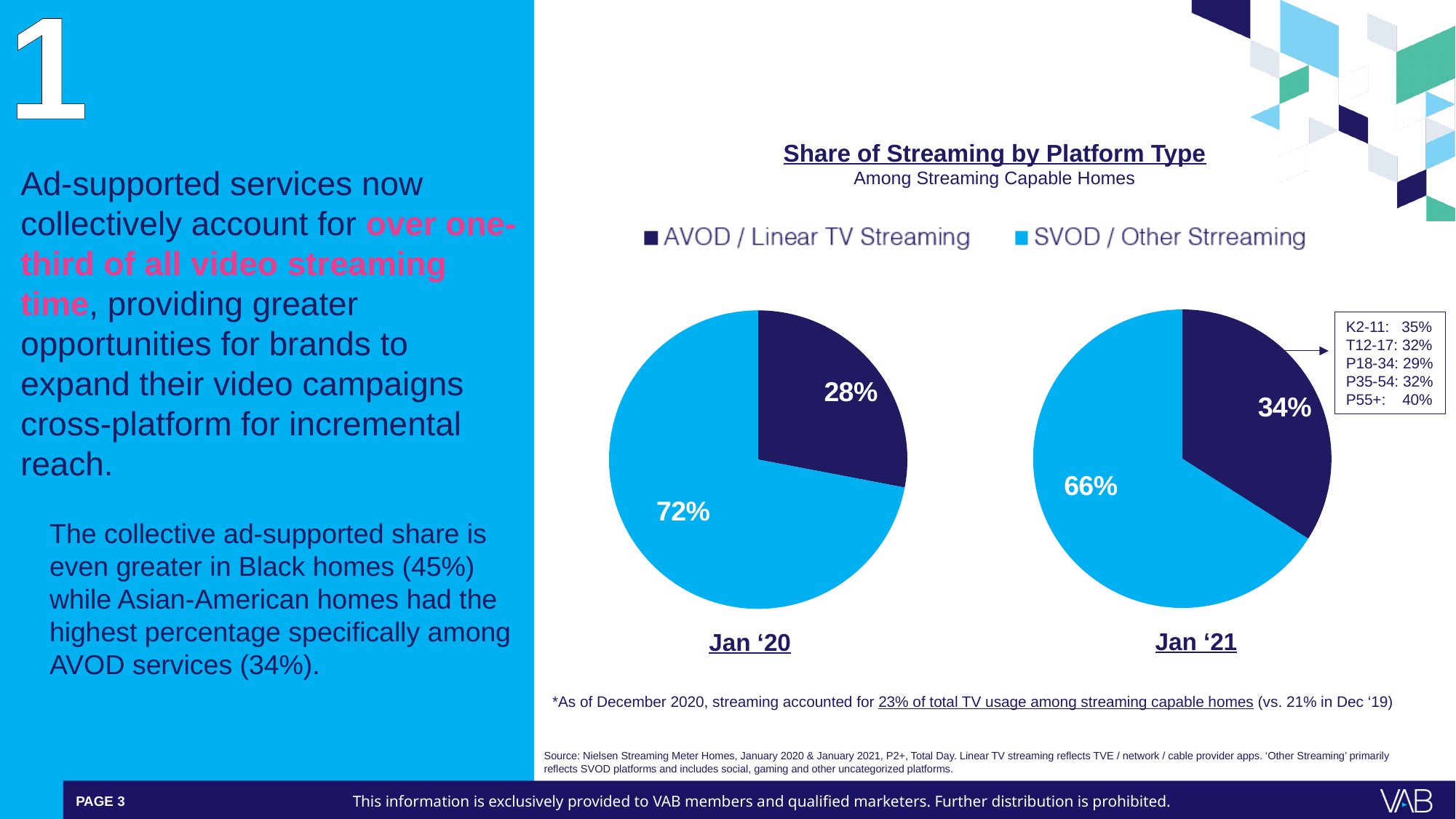
What is the title of the charts on the slide? Share of Streaming by Platform Type In the Jan '21 pie chart, which slice is the largest? SVOD / Other Streaming In the Jan '20 pie chart, which slice is the smallest? AVOD / Linear TV Streaming How many series does the legend list for the pie charts? 2 In the Jan '21 pie chart, what share is SVOD / Other Streaming? 66% What type of charts are shown on the slide? Pie charts By how many percentage points did the AVOD / Linear TV Streaming share change from the Jan '20 pie chart to the Jan '21 pie chart? 6 percentage points In the callout next to the Jan '21 pie chart, what is the AVOD share for P55+? 40% In the Jan '21 pie chart, what share is AVOD / Linear TV Streaming? 34% In the Jan '20 pie chart, what share is AVOD / Linear TV Streaming? 28% Is the AVOD / Linear TV Streaming share larger in the Jan '20 pie chart or the Jan '21 pie chart? Jan '21 In the Jan '20 pie chart, what share is SVOD / Other Streaming? 72%